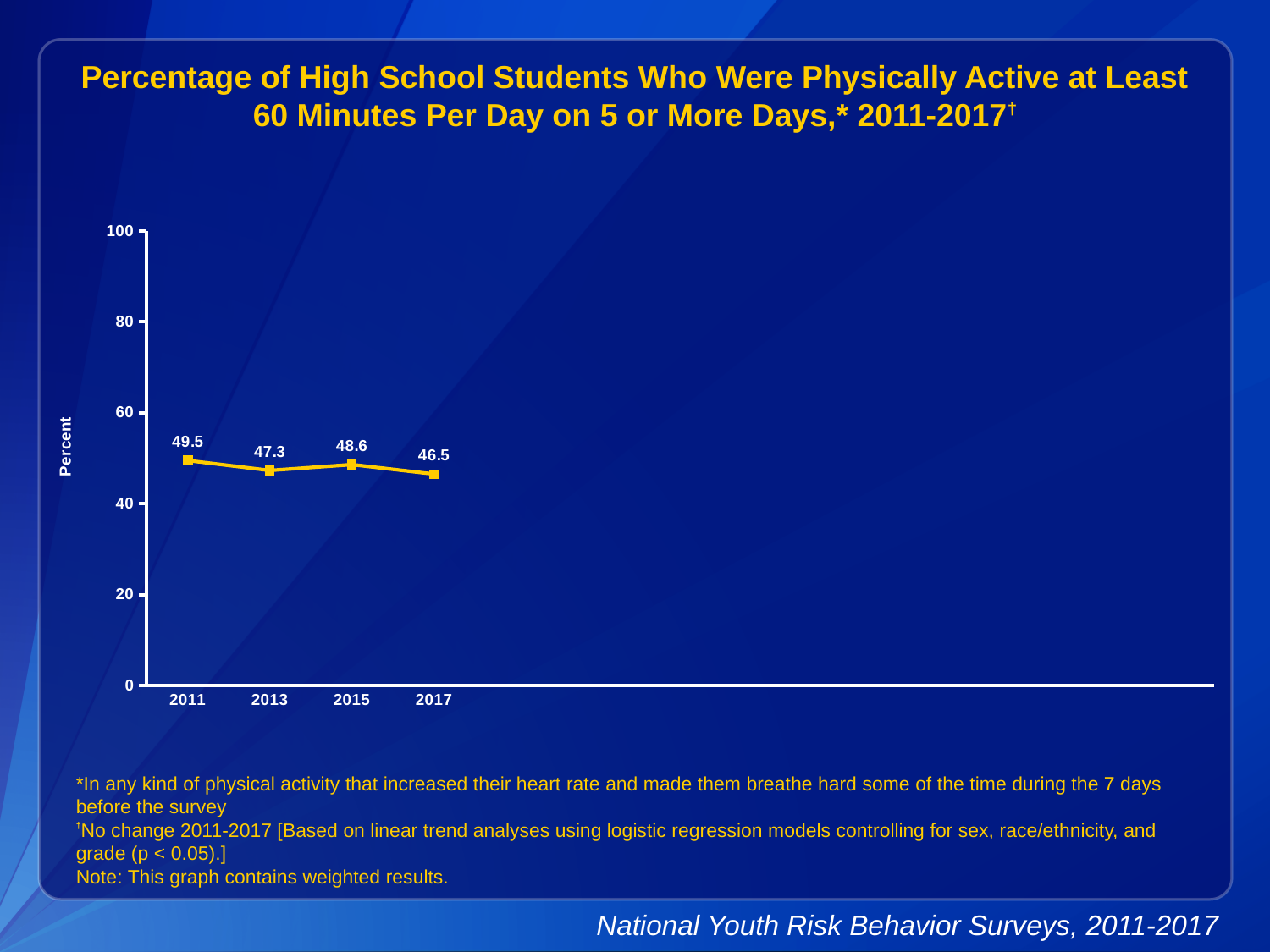
Is the value for 2017 greater or less than 60? less What value is shown for 2017? 46.5 What value is shown for 2015? 48.6 Which is larger, the value for 2013 or the value for 2015? 2015 What kind of chart is shown on the slide? line chart Which year has the highest value? 2011 Which year has the lowest value? 2017 How many years are plotted on the chart? 4 What is the label on the vertical axis? Percent What value is shown for 2013? 47.3 What was the percentage of high school students who were physically active at least 60 minutes per day on 5 or more days in 2011? 49.5 What is the difference between the 2011 value and the 2017 value? 3.0